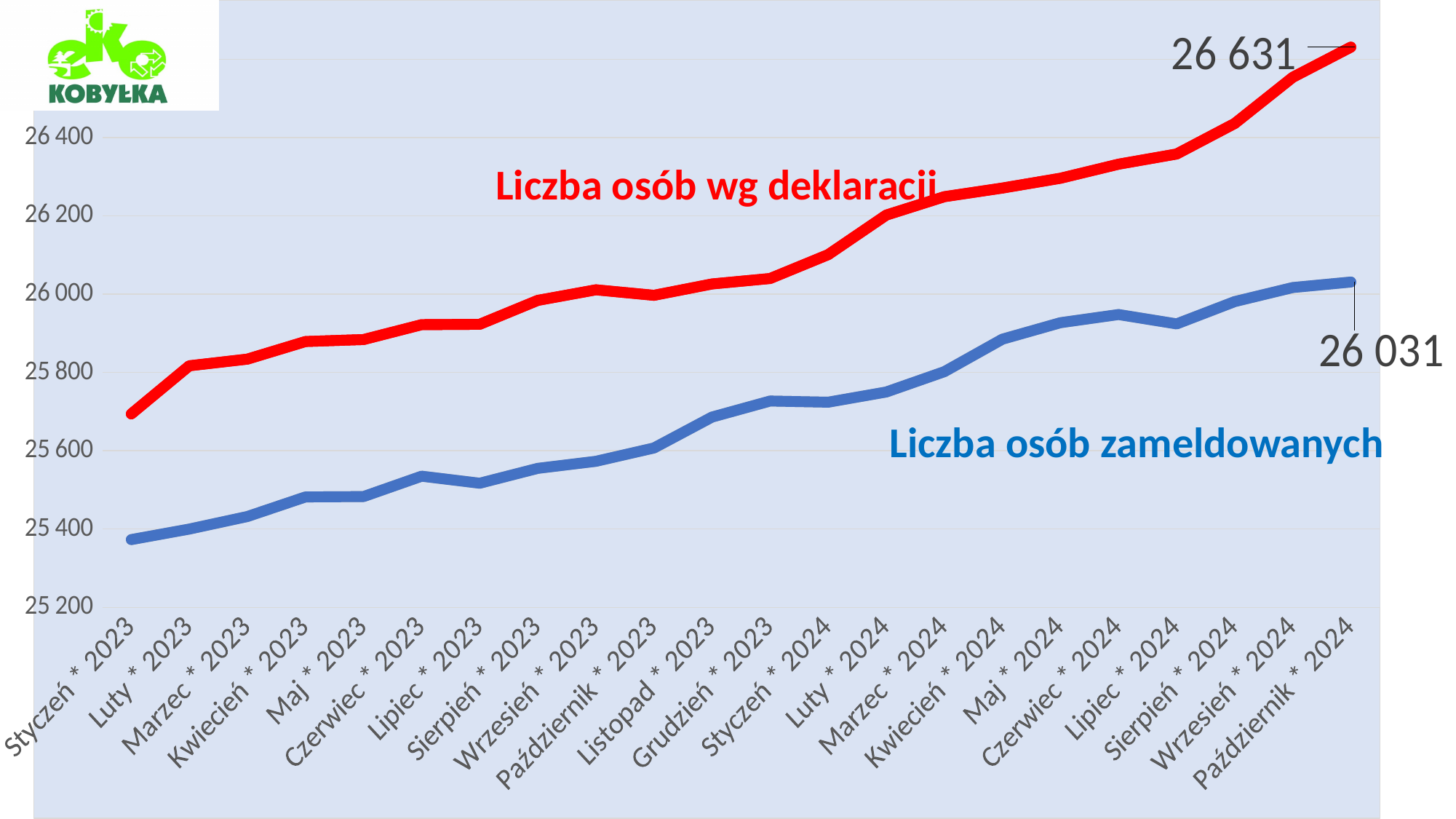
Which series is higher in Październik * 2024, 'Liczba osób wg deklaracji' or 'Liczba osób zameldowanych'? Liczba osób wg deklaracji What is the value of 'Liczba osób wg deklaracji' for Październik * 2024? 26 631 Is the value of 'Liczba osób wg deklaracji' for Styczeń * 2023 greater or less than 25 800? less What is the value of 'Liczba osób zameldowanych' for Październik * 2024? 26 031 What type of chart is shown on the slide? line chart What is the difference between 'Liczba osób wg deklaracji' and 'Liczba osób zameldowanych' in Październik * 2024? 600 Is the value of 'Liczba osób wg deklaracji' for Sierpień * 2024 greater or less than 26 200? greater How many series are plotted on the chart? 2 Is the value of 'Liczba osób zameldowanych' for Styczeń * 2023 greater or less than 25 400? less Does 'Liczba osób wg deklaracji' generally rise or fall from Styczeń * 2023 to Październik * 2024? rise What colour is the line for 'Liczba osób zameldowanych'? blue How many months (data points) are shown along the x axis? 22